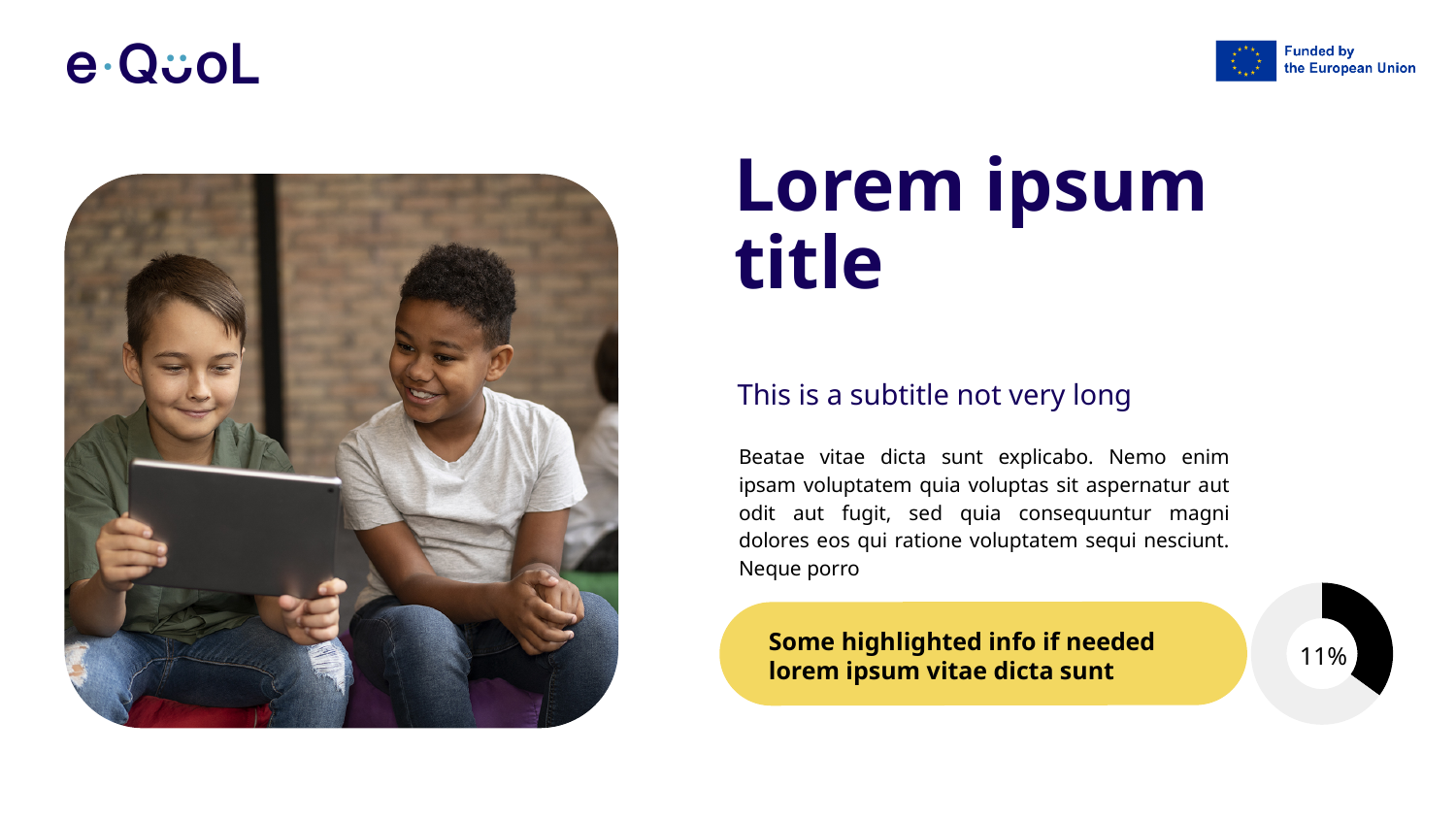
What kind of chart is shown at the bottom right of the slide? Donut chart How many segments does the donut chart at the bottom right of the slide have? 2 What percentage is shown in the centre of the donut chart at the bottom right of the slide? 11% What colour is the highlighted segment of the donut chart at the bottom right of the slide? Black What colour is the remaining (non-highlighted) part of the donut chart at the bottom right of the slide? Light grey In the donut chart at the bottom right, which segment is larger, the black one or the grey one? The grey one